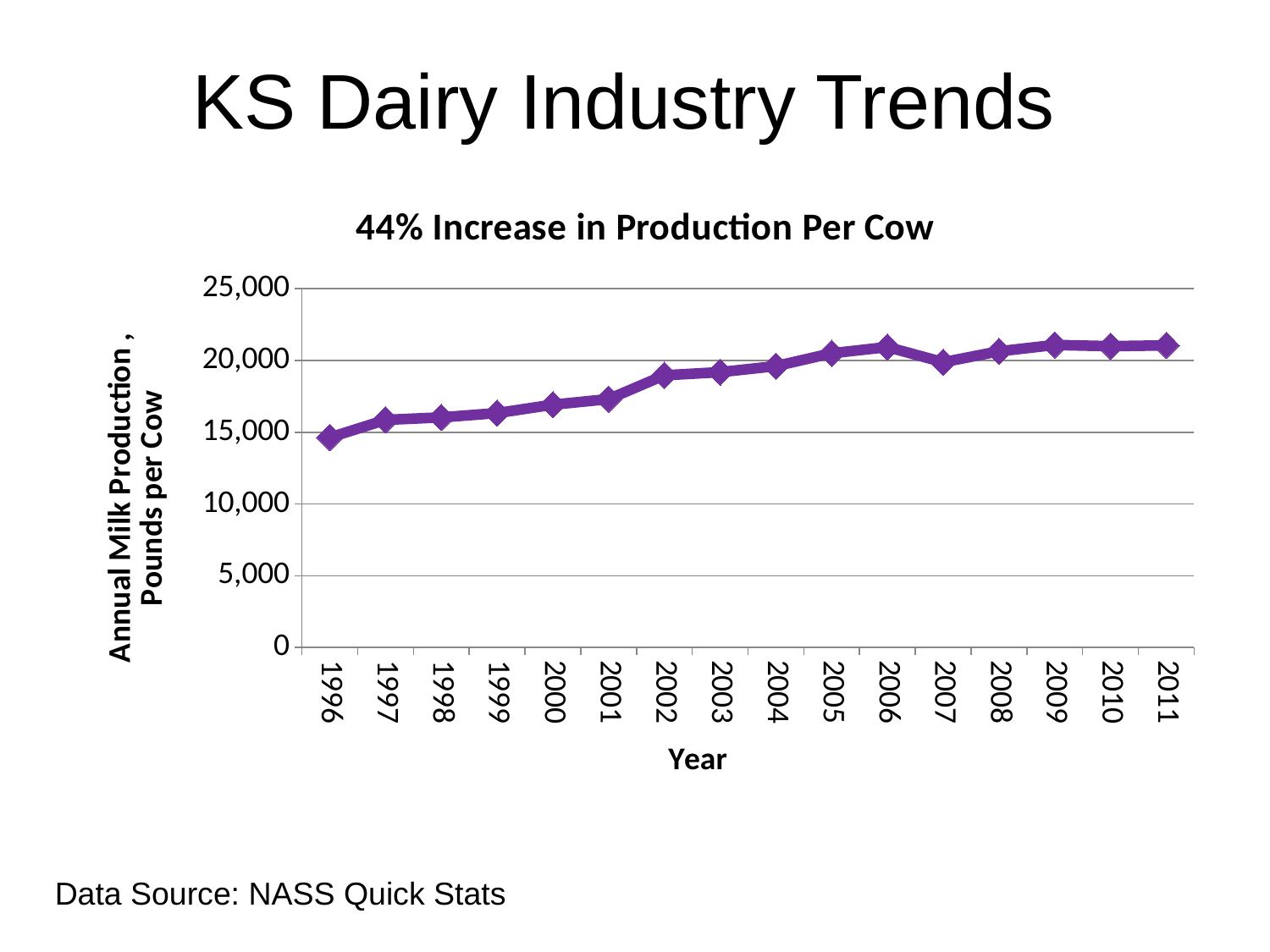
Which year has the larger value, 2001 or 2002? 2002 Which year has the lowest annual milk production per cow? 1996 Is the value for 2001 greater or less than 20,000? less Which year has the larger value, 1996 or 2005? 2005 What is the label of the y axis? Annual Milk Production, Pounds per Cow How many years are plotted on the x axis? 16 What is the title of the chart? 44% Increase in Production Per Cow Overall, do the values rise or fall from 1996 to 2011? rise What kind of chart is shown on the slide? line chart Is the value for 2000 greater or less than 15,000? greater